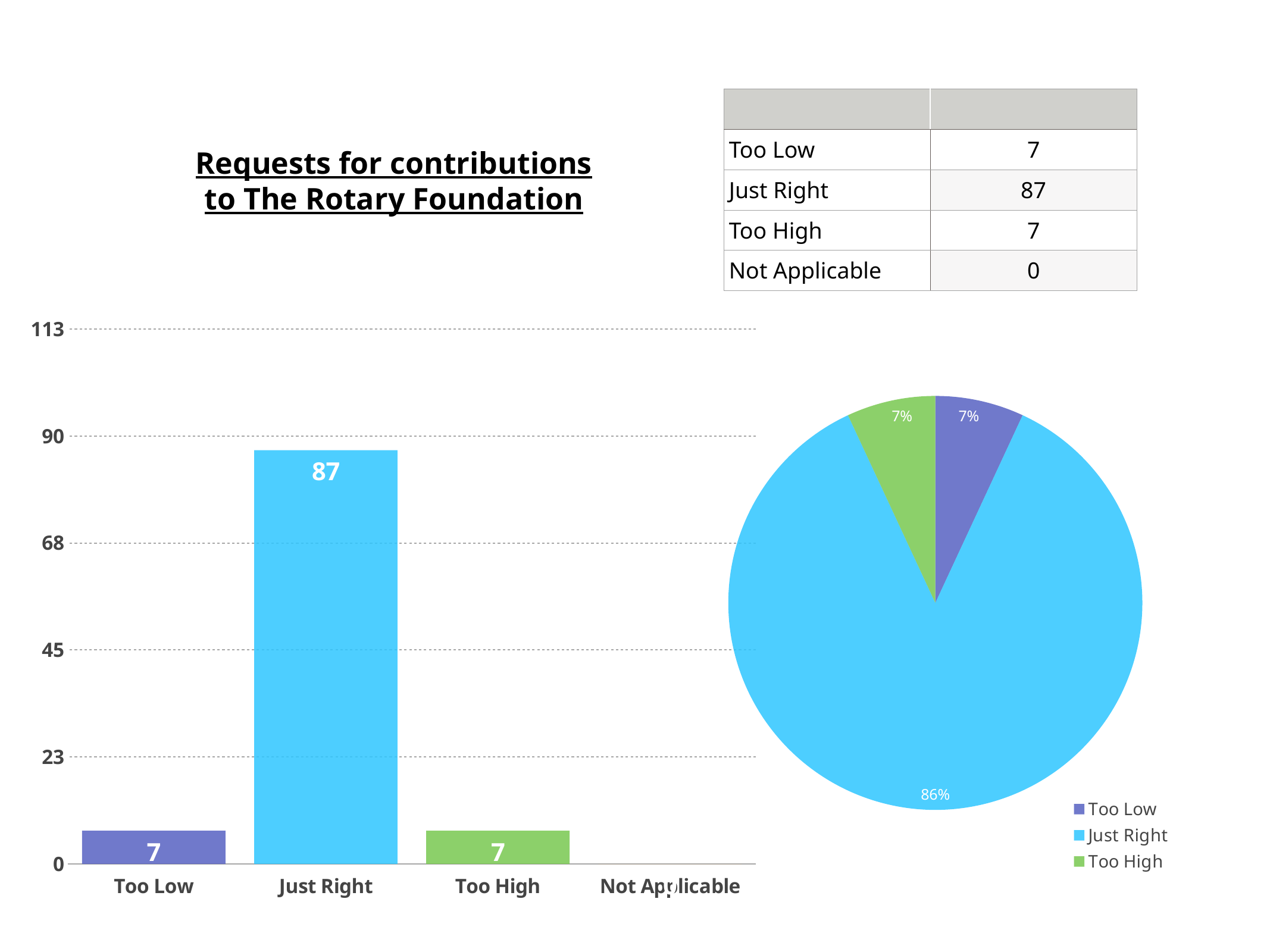
In the bar chart on the left, what is the value for Just Right? 87 How many entries does the legend of the pie chart on the right list? 3 In the bar chart on the left, which category has the highest value? Just Right How many categories are shown on the x axis of the bar chart on the left? 4 What kind of chart is the chart on the left of the slide? bar chart In the bar chart on the left, what is the difference between the values for Just Right and Too High? 80 In the pie chart on the right, what share does Just Right have? 86% In the bar chart on the left, what is the value for Too Low? 7 What kind of chart is the chart on the right of the slide? pie chart In the pie chart on the right, what share does Too High have? 7% In the bar chart on the left, is the value for Just Right greater or less than 68? greater In the bar chart on the left, which is larger, the value for Just Right or the value for Too Low? Just Right